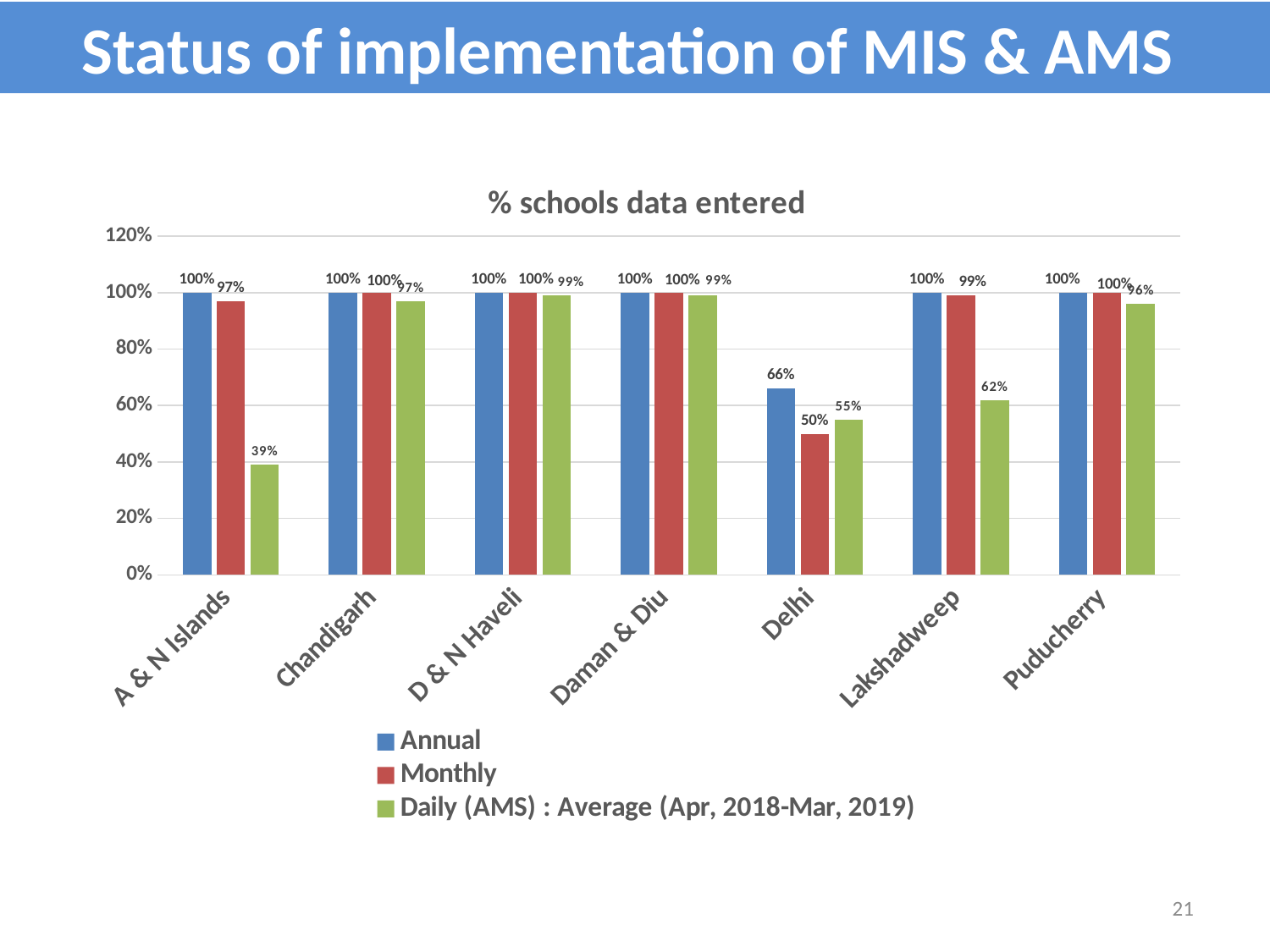
Is the Daily (AMS) value for Lakshadweep greater or less than 80%? less What is the Daily (AMS) value for A & N Islands? 39% What is the Monthly value for Delhi? 50% Which category has the lowest Daily (AMS) value? A & N Islands How many series does the legend list? 3 What is the Annual value for Delhi? 66% What is the Daily (AMS) value for Lakshadweep? 62% What is the difference between the Annual and Daily (AMS) values for A & N Islands? 61% Which is larger for Delhi, the Monthly value or the Daily (AMS) value? Daily (AMS) How many categories are shown on the x axis? 7 What type of chart is shown on the slide? bar chart Which category has the lowest Annual value? Delhi